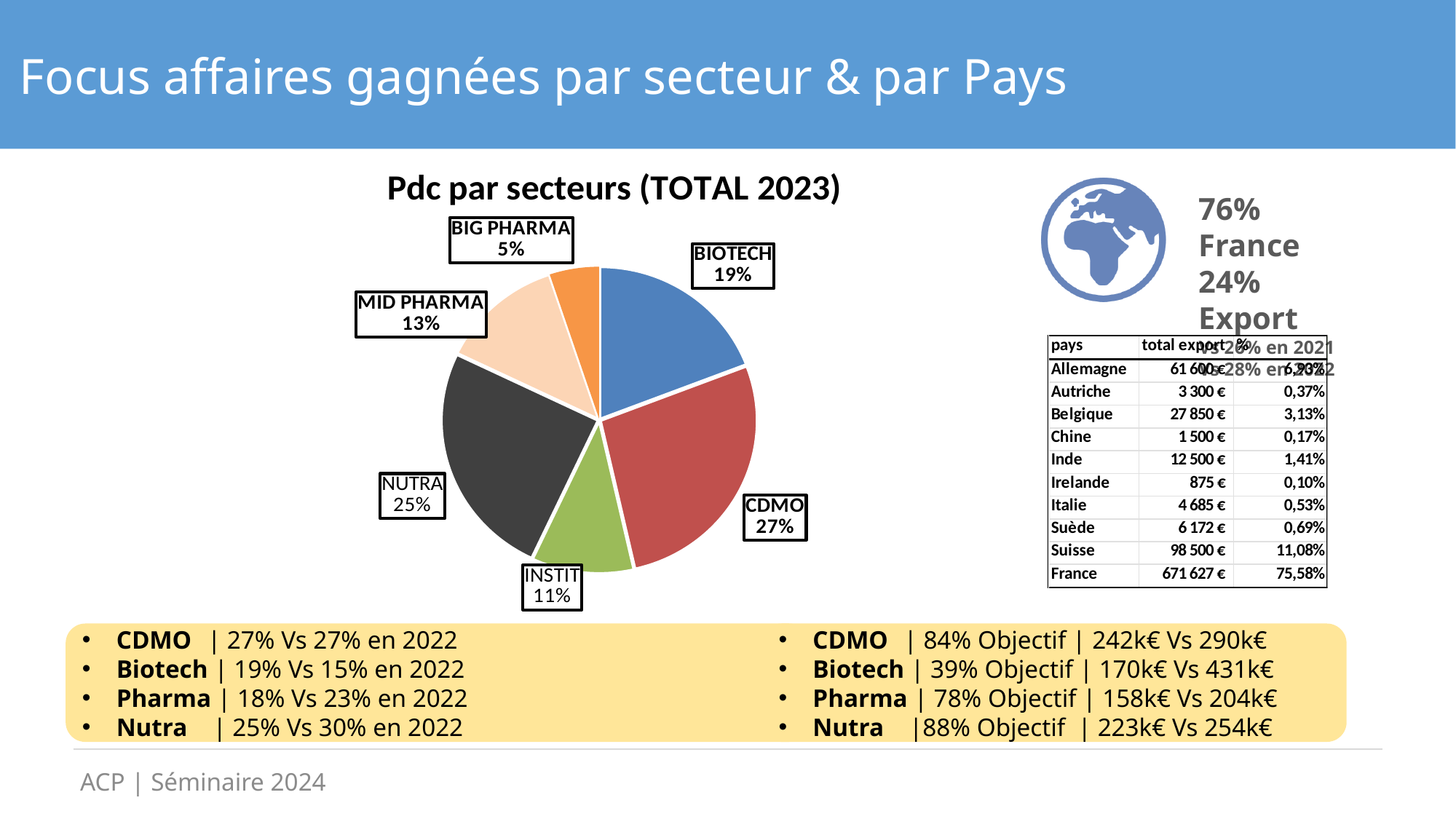
How many slices does the pie chart have? 6 What share of the pie does MID PHARMA hold? 13% What share of the pie does CDMO hold? 27% What is the title of the pie chart? Pdc par secteurs (TOTAL 2023) What share of the pie does INSTIT hold? 11% What is the difference in percentage points between the NUTRA slice and the BIG PHARMA slice? 20% What kind of chart is shown on the slide? Pie chart What share of the pie does BIOTECH hold? 19% Which slice is larger, NUTRA or BIOTECH? NUTRA Which sector has the smallest slice of the pie? BIG PHARMA Which sector has the largest slice of the pie? CDMO What colour is the NUTRA slice of the pie? Dark grey